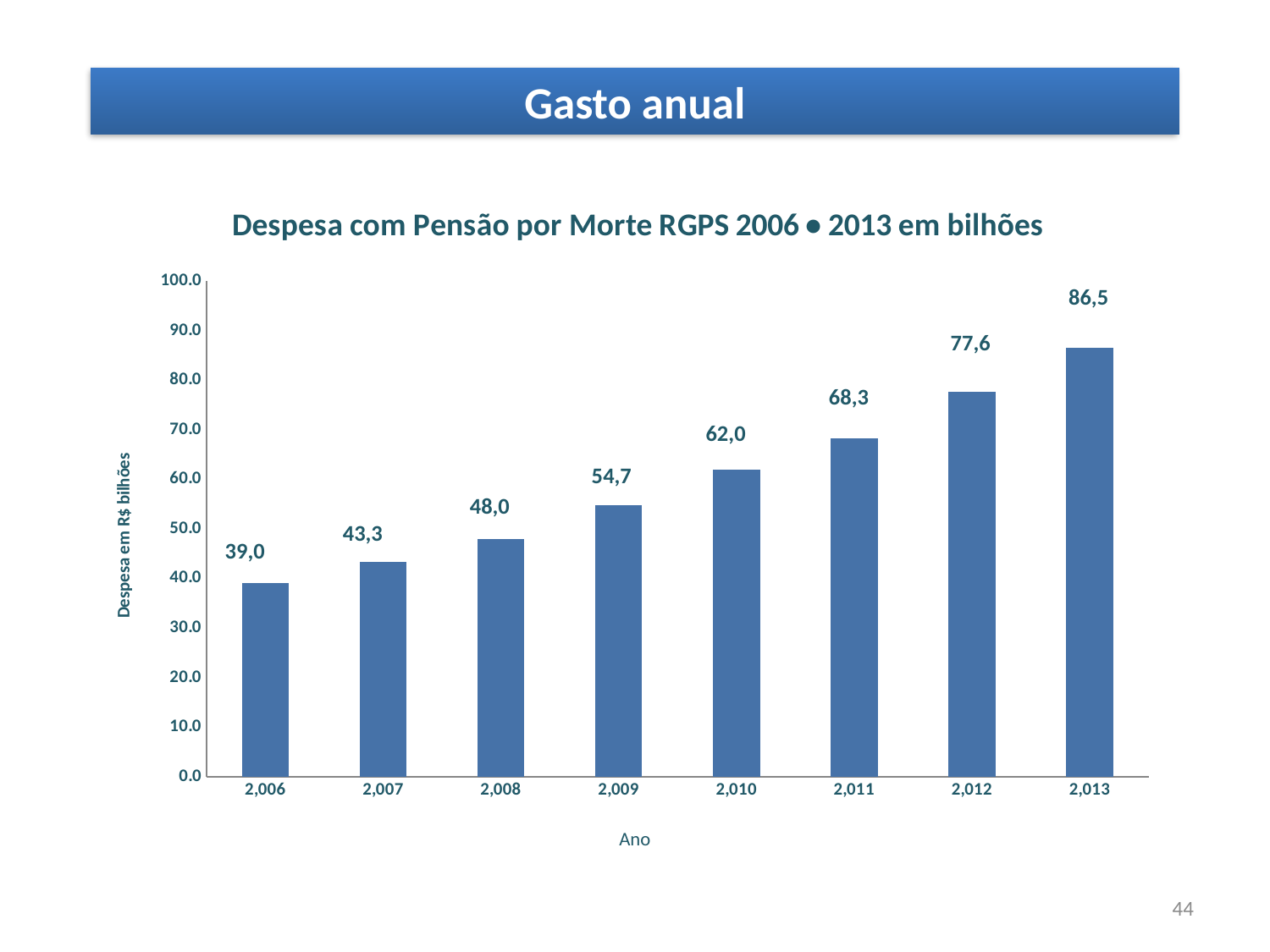
What is the value for 2,009 in the chart? 54,7 Which is larger, the value for 2,010 or the value for 2,008? 2,010 What is the difference between the values for 2,012 and 2,011? 9,3 Is the value for 2,011 greater or less than 60.0? greater What is the value for 2,013 in the chart? 86,5 What kind of chart is shown on the slide? bar chart Which year has the highest value in the chart? 2,013 Do the values rise or fall from 2,006 to 2,013? rise What is the value for 2,006 in the chart? 39,0 What is the difference between the values for 2,013 and 2,006? 47,5 Which year has the lowest value in the chart? 2,006 How many years are shown on the x axis of the chart? 8